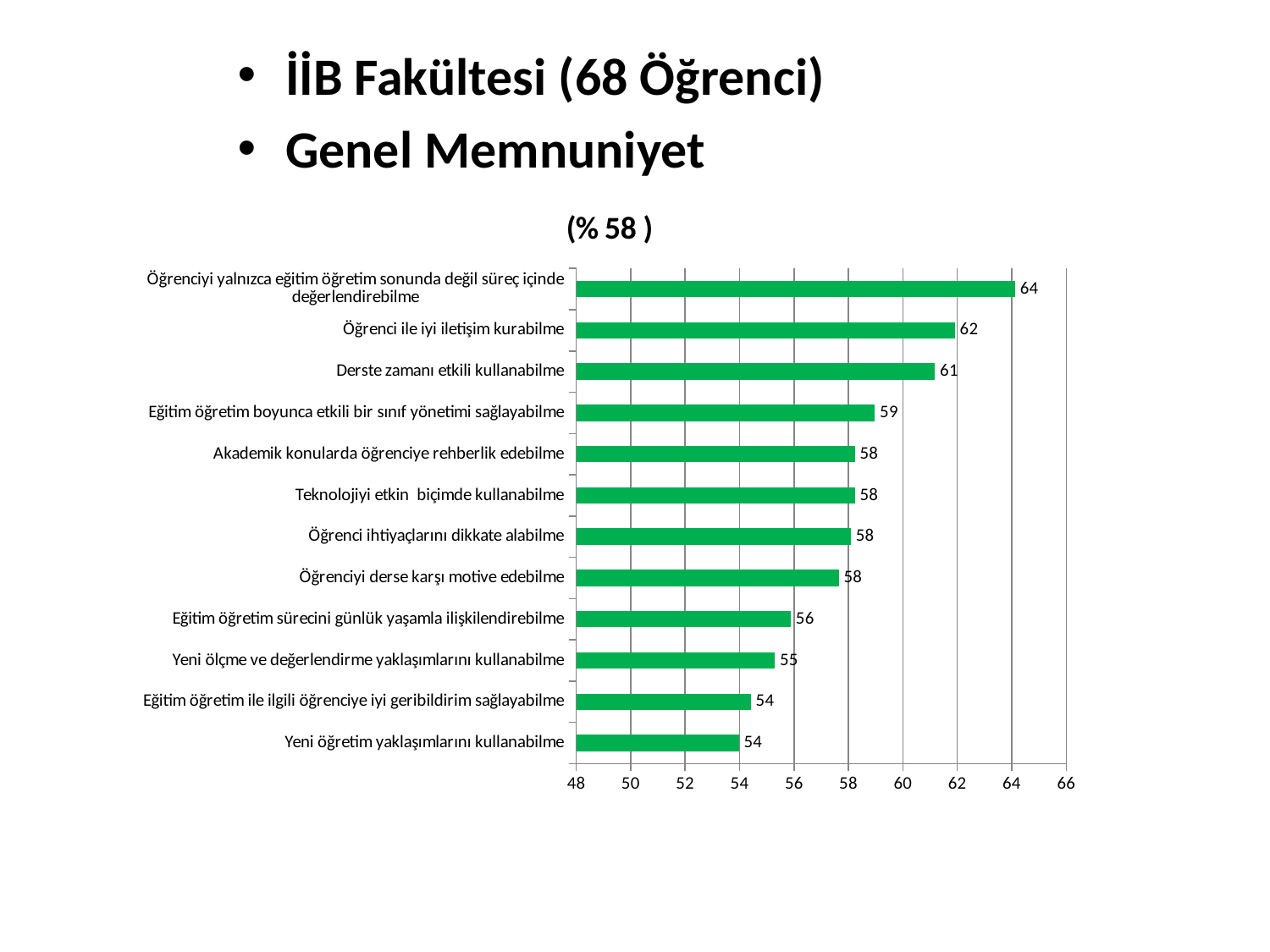
How many categories are plotted in the chart? 12 What is the difference between the value for "Öğrenciyi yalnızca eğitim öğretim sonunda değil süreç içinde değerlendirebilme" and the value for "Yeni öğretim yaklaşımlarını kullanabilme"? 10 What is the value for "Derste zamanı etkili kullanabilme"? 61 What is the value for "Öğrenci ile iyi iletişim kurabilme"? 62 What is the value for "Eğitim öğretim boyunca etkili bir sınıf yönetimi sağlayabilme"? 59 Which category has the highest value? Öğrenciyi yalnızca eğitim öğretim sonunda değil süreç içinde değerlendirebilme What is the value for "Yeni ölçme ve değerlendirme yaklaşımlarını kullanabilme"? 55 Is the value for "Yeni öğretim yaklaşımlarını kullanabilme" greater or less than 56? less What type of chart is shown on the slide? bar chart What is the value for "Eğitim öğretim sürecini günlük yaşamla ilişkilendirebilme"? 56 What is the chart's title? (% 58 ) Which is larger: the value for "Öğrenci ile iyi iletişim kurabilme" or the value for "Eğitim öğretim ile ilgili öğrenciye iyi geribildirim sağlayabilme"? Öğrenci ile iyi iletişim kurabilme